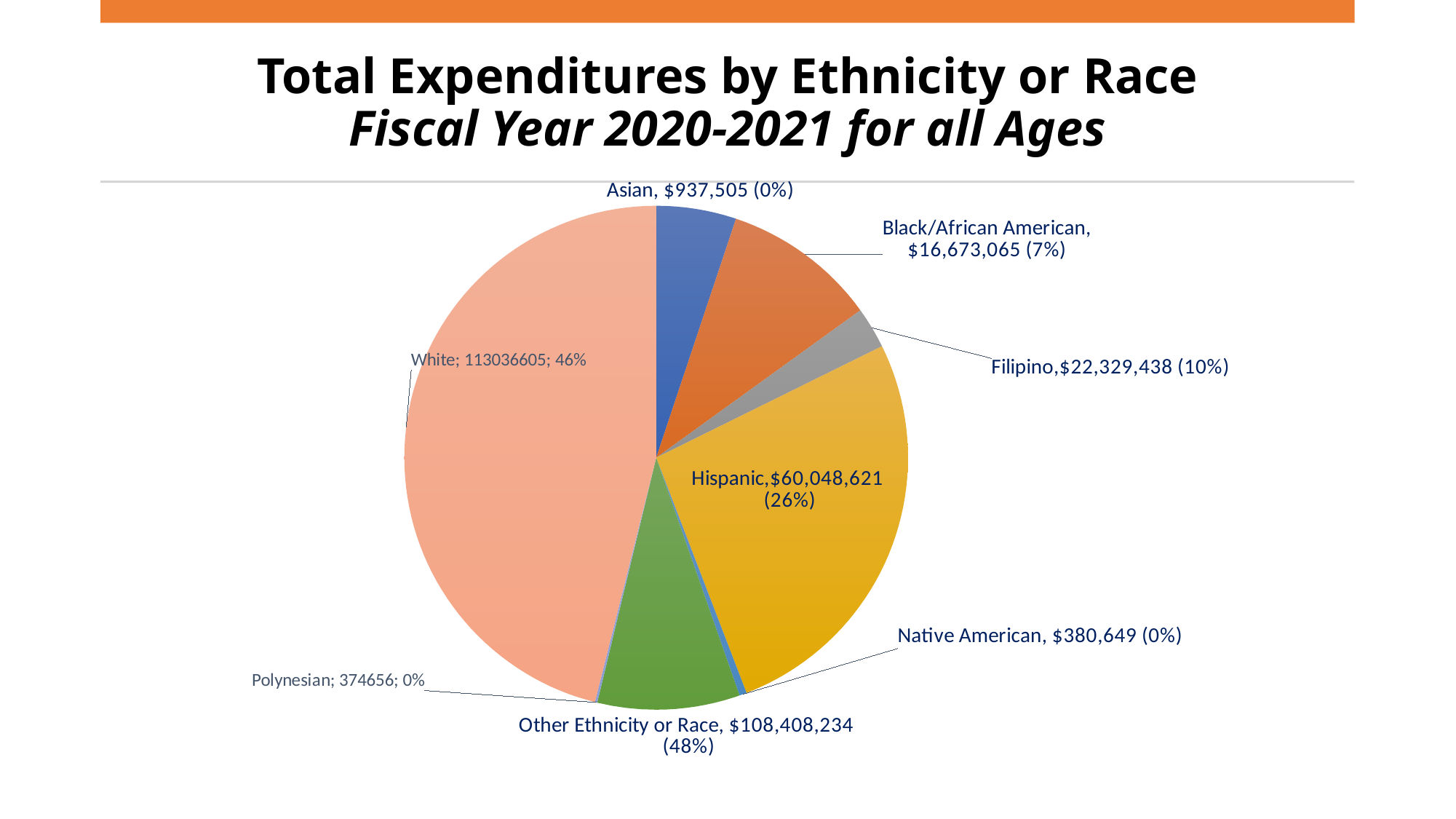
How many ethnicity or race categories are shown in the pie chart? 8 What percentage share of the pie is labelled for Black/African American? 7% What is the total expenditure shown for Native American? $380,649 What is the total expenditure shown for Asian? $937,505 Which has the larger expenditure, Hispanic or Black/African American? Hispanic What is the total expenditure shown for Hispanic? $60,048,621 What kind of chart is shown on the slide? Pie chart What is the title of the chart on the slide? Total Expenditures by Ethnicity or Race Fiscal Year 2020-2021 for all Ages What percentage share of the pie is labelled for Hispanic? 26% What is the total expenditure shown for Filipino? $22,329,438 What is the difference between the expenditures for Hispanic and Filipino? $37,719,183 What is the total expenditure shown for Black/African American? $16,673,065